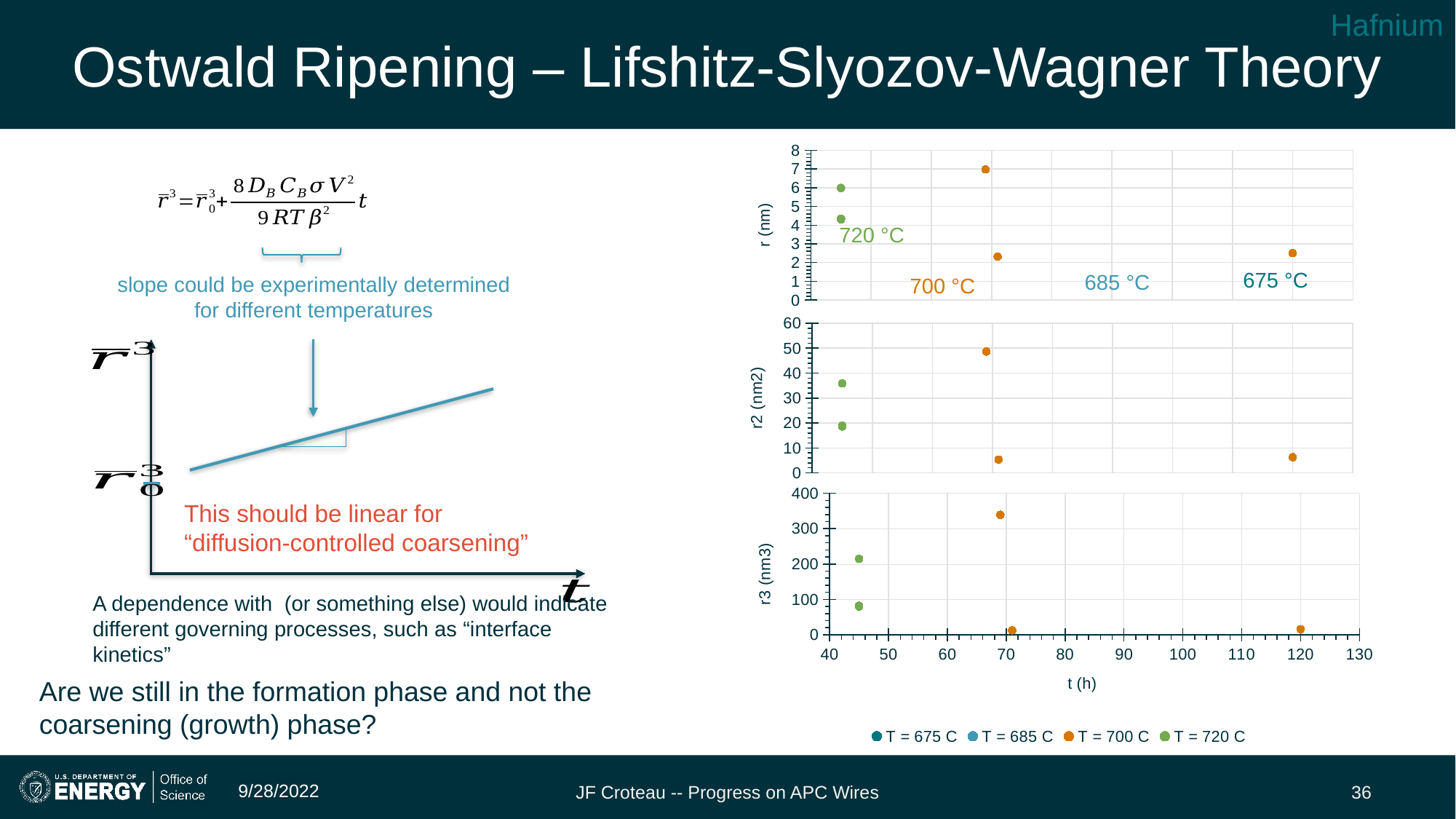
In the bottom chart (r3 (nm3)), is the highest plotted value greater or less than 300? greater What is the label of the x axis shared by the three charts? t (h) In the middle chart (r2 (nm2)), how many data points are plotted? 5 What is the maximum value shown on the y axis of the middle chart (r2 (nm2))? 60 In the bottom chart (r3 (nm3)), is the value of the point near t = 120 greater or less than 100? less In the top chart (r (nm)), which series has the highest plotted point? T = 700 C What is the y-axis label of the bottom chart? r3 (nm3) In the middle chart (r2 (nm2)), is the highest plotted value greater or less than 40? greater In the top chart (r (nm)), how many data points are plotted? 5 What kind of chart is the top chart (r (nm) vs t (h))? scatter chart How many series does the legend at the bottom of the slide list? 4